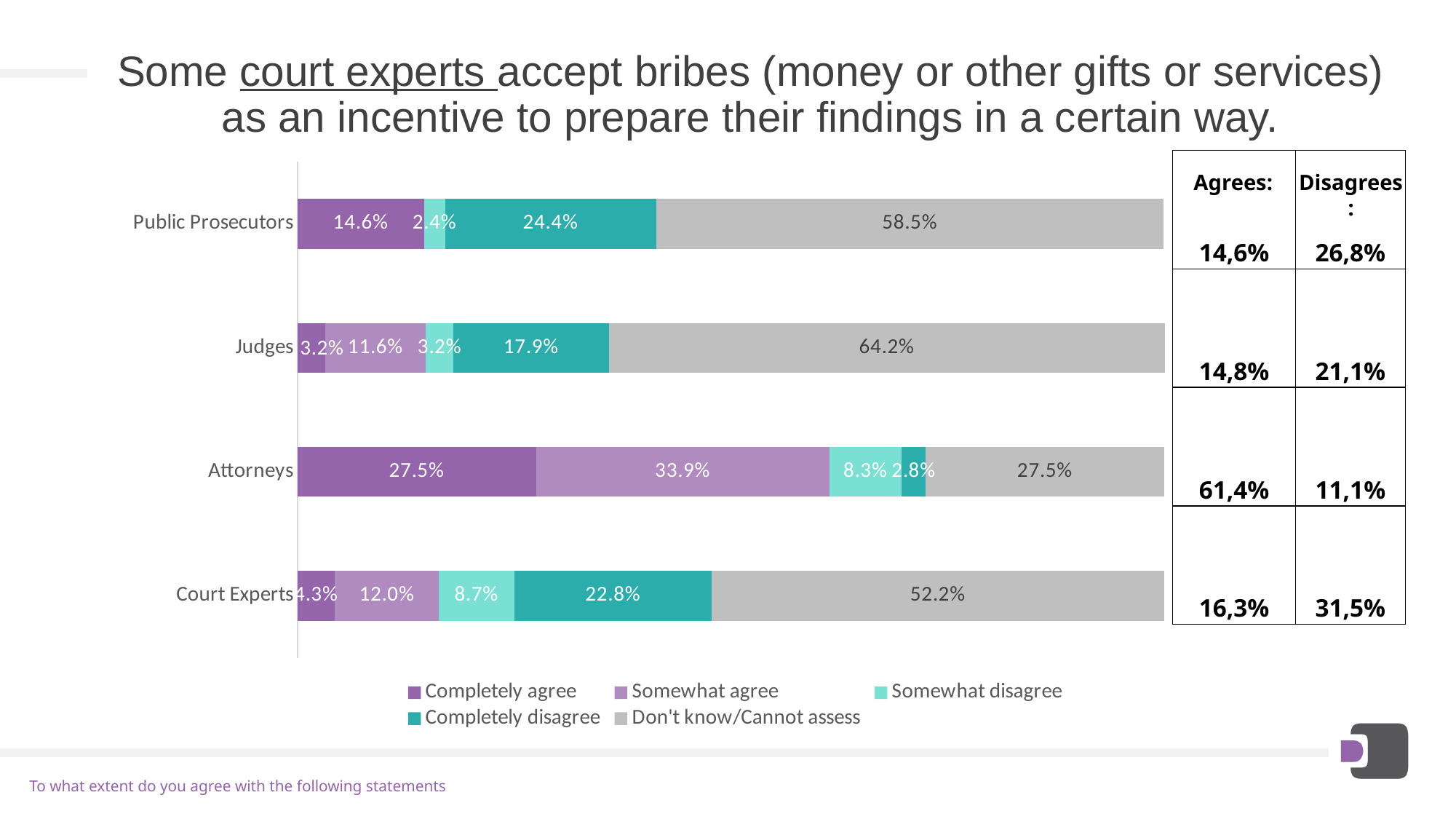
How many categories are plotted on the chart? 4 What is the 'Completely disagree' value for Court Experts? 22.8% Which category has the highest 'Somewhat agree' value? Attorneys What is the 'Don't know/Cannot assess' value for Judges? 64.2% Which legend entry is shown in grey? Don't know/Cannot assess Which is larger, the 'Completely disagree' value for Public Prosecutors or for Judges? Public Prosecutors What is the difference between the 'Don't know/Cannot assess' values for Judges and Court Experts? 12.0% Which category has the lowest 'Don't know/Cannot assess' value? Attorneys How many series does the legend list? 5 What is the 'Somewhat disagree' value for Public Prosecutors? 2.4% What kind of chart is shown on the slide? Stacked bar chart What is the 'Completely agree' value for Attorneys? 27.5%